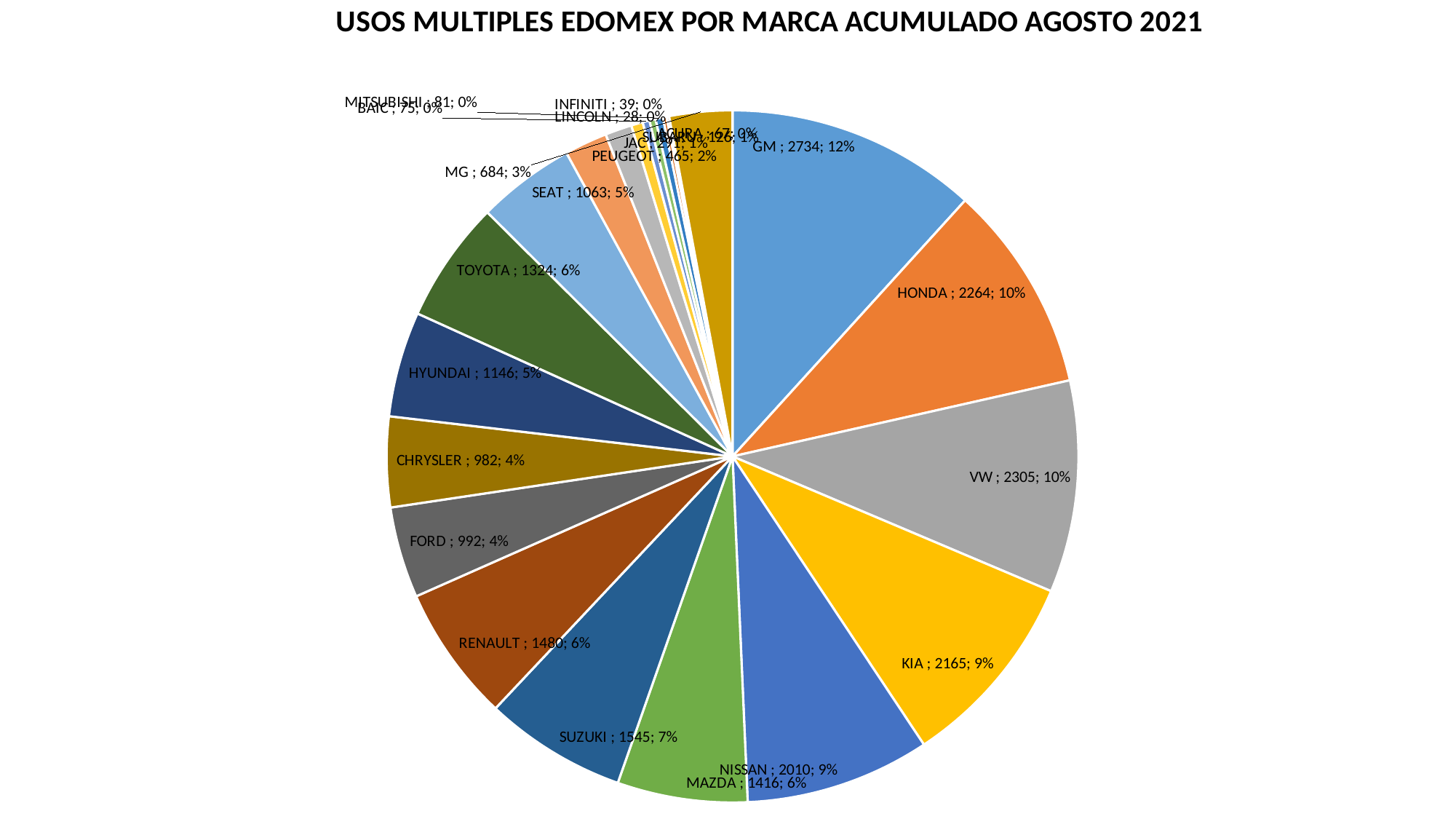
What is the value shown for GM? 2734 Which is larger, the value for KIA or the value for NISSAN? KIA What share of the pie does HYUNDAI represent? 5% Which is larger, the value for VW or the value for HONDA? VW What is the value shown for TOYOTA? 1324 Which brand has the smallest value shown on the chart? LINCOLN What is the difference between the values for GM and HONDA? 470 Which brand has the largest slice of the pie? GM What is the value shown for RENAULT? 1480 What is the title of the chart? USOS MULTIPLES EDOMEX POR MARCA ACUMULADO AGOSTO 2021 What kind of chart is shown on the slide? pie chart What share of the pie does KIA represent? 9%